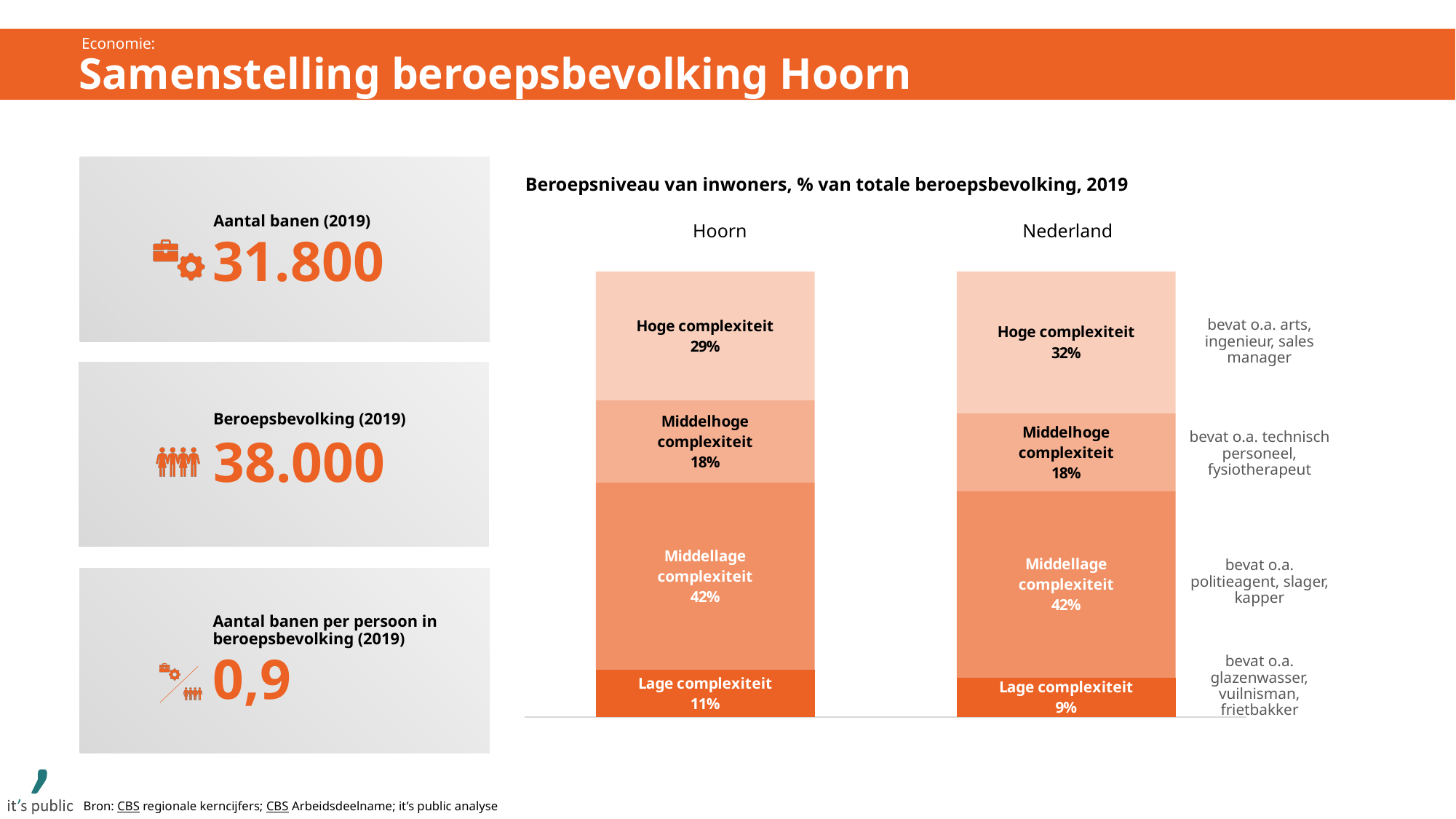
What percentage of Hoorn's beroepsbevolking is in the 'Hoge complexiteit' category? 29% Which category has the smallest share in the Nederland bar? Lage complexiteit What is the value for 'Lage complexiteit' in the Nederland bar? 9% Which category has the largest share in the Hoorn bar? Middellage complexiteit How many percentage points higher is 'Hoge complexiteit' for Nederland than for Hoorn? 3 percentage points What type of chart is shown on the slide? Stacked bar chart Which has a larger share of 'Lage complexiteit', Hoorn or Nederland? Hoorn What is the value for 'Middelhoge complexiteit' in the Nederland bar? 18% How many complexity categories does each bar contain? 4 How many bars are shown in the chart? 2 What is the title of the chart? Beroepsniveau van inwoners, % van totale beroepsbevolking, 2019 In the Hoorn bar, how many percentage points larger is 'Middellage complexiteit' than 'Hoge complexiteit'? 13 percentage points